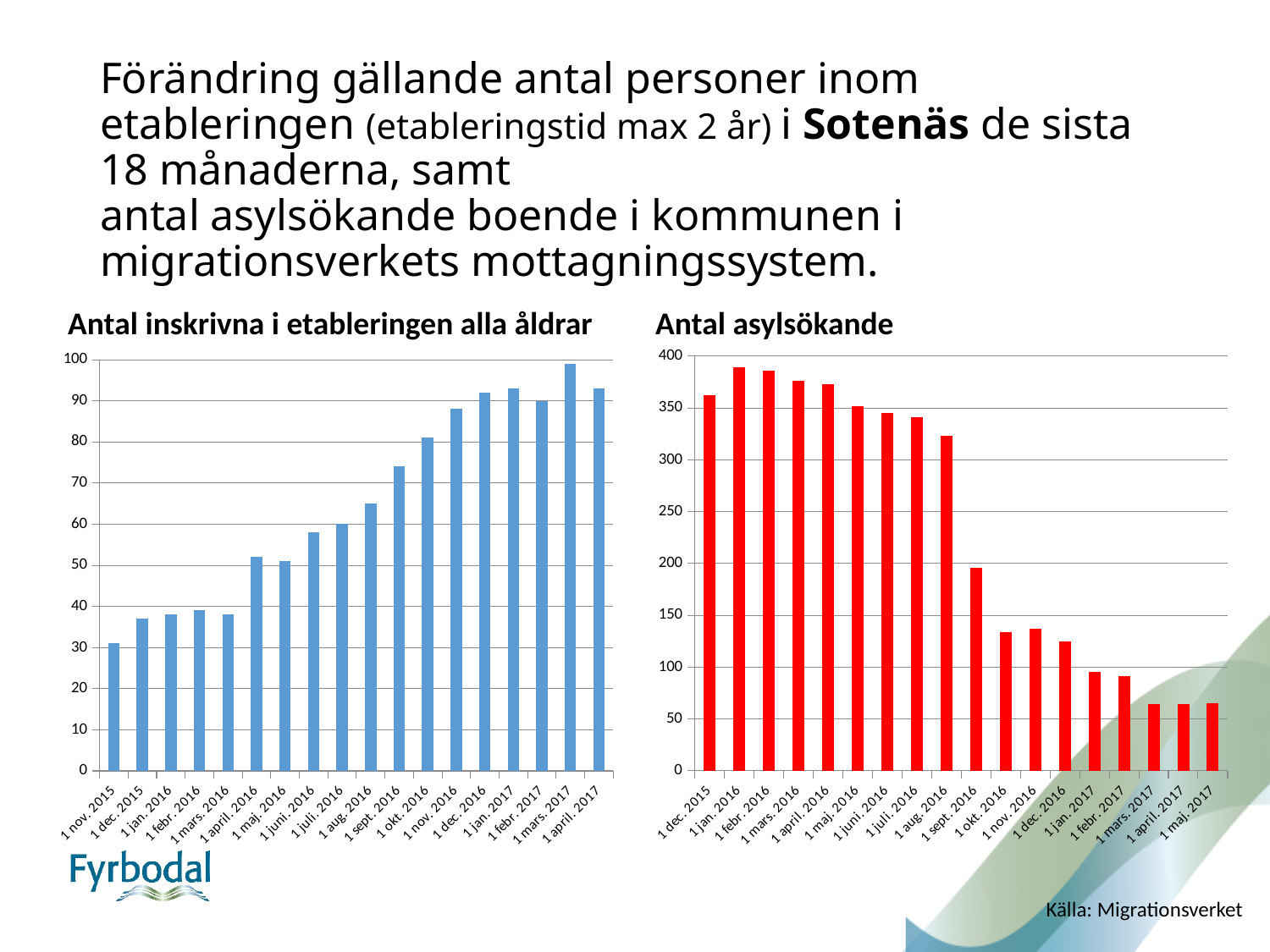
How many bars are shown in the chart titled 'Antal asylsökande'? 18 In the chart titled 'Antal inskrivna i etableringen alla åldrar', is the value for 1 mars 2017 greater or less than 90? greater In the chart titled 'Antal asylsökande', is the value for 1 dec. 2015 greater or less than 300? greater In the chart titled 'Antal inskrivna i etableringen alla åldrar', do the values generally rise or fall from left to right? rise In the chart titled 'Antal inskrivna i etableringen alla åldrar', is the value for 1 nov. 2015 greater or less than 40? less In the chart titled 'Antal inskrivna i etableringen alla åldrar', which date has the lowest bar? 1 nov. 2015 In the chart titled 'Antal asylsökande', do the values generally rise or fall from left to right? fall In the chart titled 'Antal inskrivna i etableringen alla åldrar', which is larger: the value for 1 april 2016 or the value for 1 okt. 2016? 1 okt. 2016 In the chart titled 'Antal asylsökande', which is larger: the value for 1 aug. 2016 or the value for 1 sept. 2016? 1 aug. 2016 What type of chart is the chart titled 'Antal asylsökande'? bar chart In the chart titled 'Antal inskrivna i etableringen alla åldrar', which date has the highest bar? 1 mars 2017